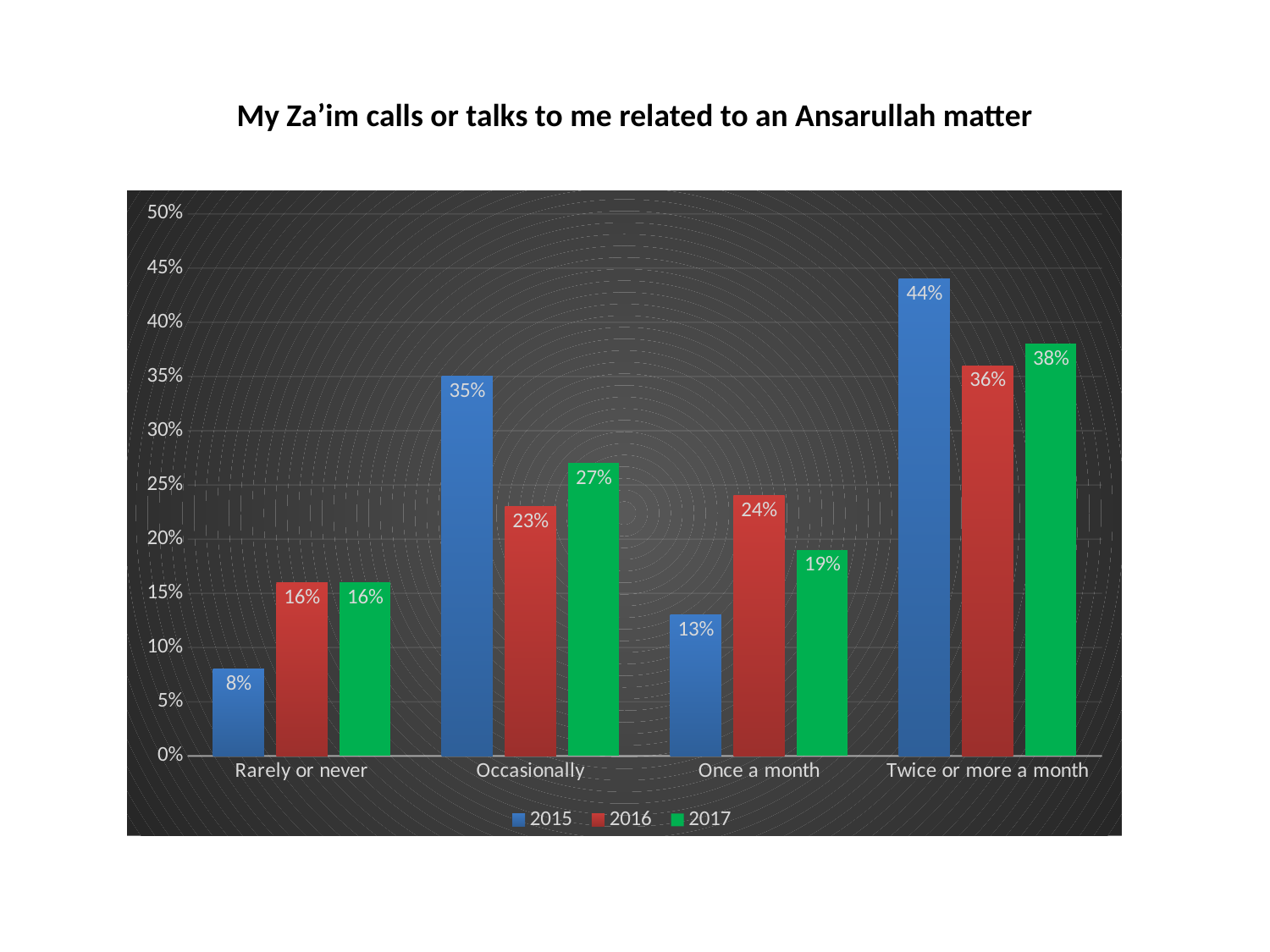
What kind of chart is shown on the slide? Bar chart How many categories are shown on the x axis? 4 Is the value for 2015 in the "Occasionally" category greater or less than 30%? greater How many series does the legend list? 3 What is the difference between the 2015 and 2016 values in the "Twice or more a month" category? 8% What is the title of the chart? My Za'im calls or talks to me related to an Ansarullah matter Which category has the highest value for the 2015 series? Twice or more a month What is the value for 2017 in the "Occasionally" category? 27% In the "Once a month" category, which series has the larger value, 2015 or 2017? 2017 What is the value for 2015 in the "Rarely or never" category? 8% Which category has the lowest value for the 2017 series? Rarely or never What is the value for 2016 in the "Once a month" category? 24%